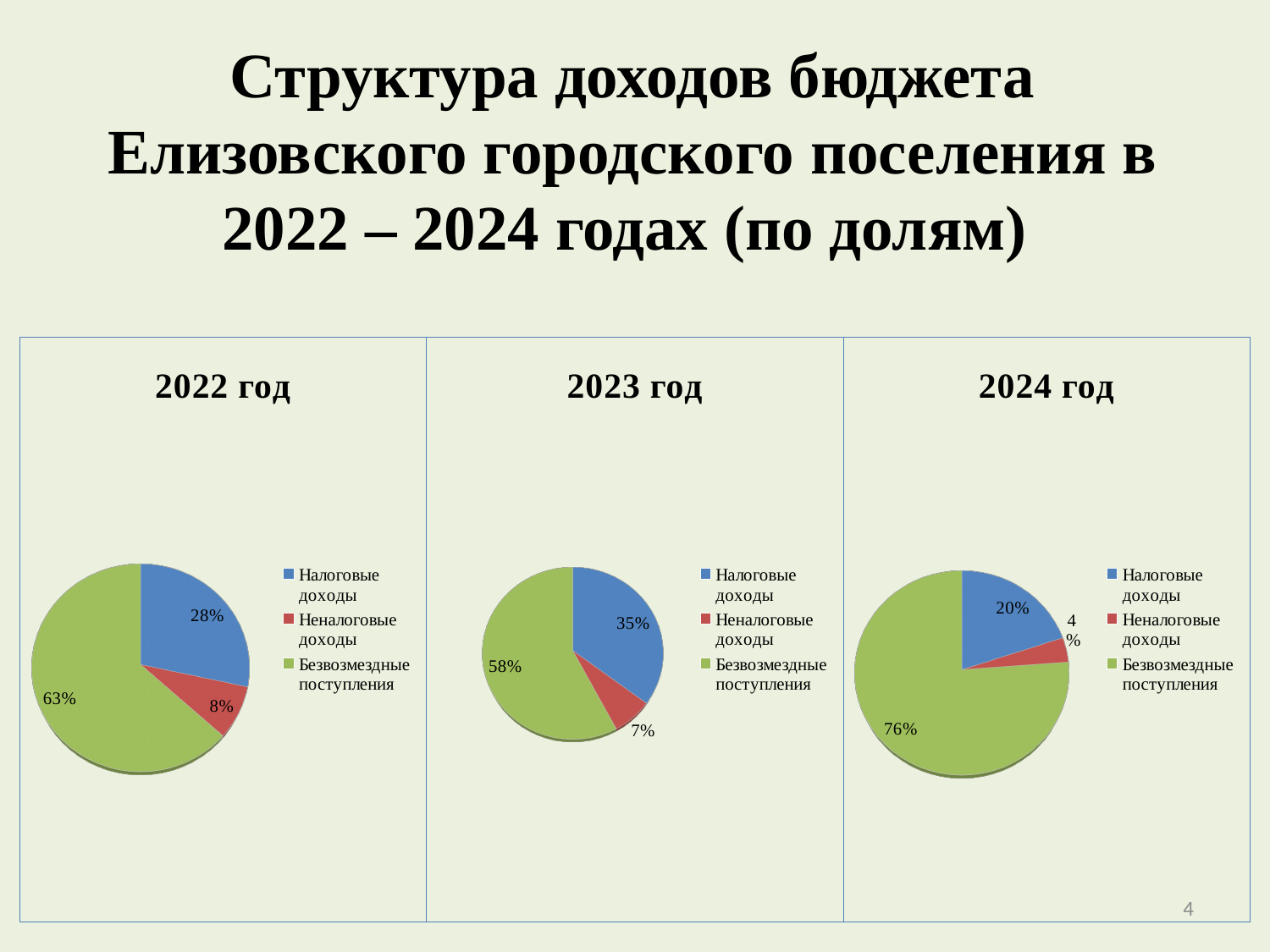
How many slices does the 2024 год pie chart have? 3 In the 2023 год chart legend, which colour represents Неналоговые доходы? Red In the 2022 год pie chart, what share is shown for Безвозмездные поступления? 63% In the 2024 год pie chart, what share is shown for Налоговые доходы? 20% In the 2023 год pie chart, what share is shown for Неналоговые доходы? 7% Which is larger: the share of Налоговые доходы in the 2022 год chart or in the 2023 год chart? 2023 год In the 2023 год pie chart, what is the difference between the shares of Безвозмездные поступления and Налоговые доходы? 23% In the 2024 год pie chart, what share is shown for Безвозмездные поступления? 76% In the 2023 год pie chart, which category has the largest slice? Безвозмездные поступления What type of chart is used for the 2022 год data? Pie chart In the 2022 год pie chart, which category has the smallest slice? Неналоговые доходы In the 2022 год pie chart, what share is shown for Налоговые доходы? 28%